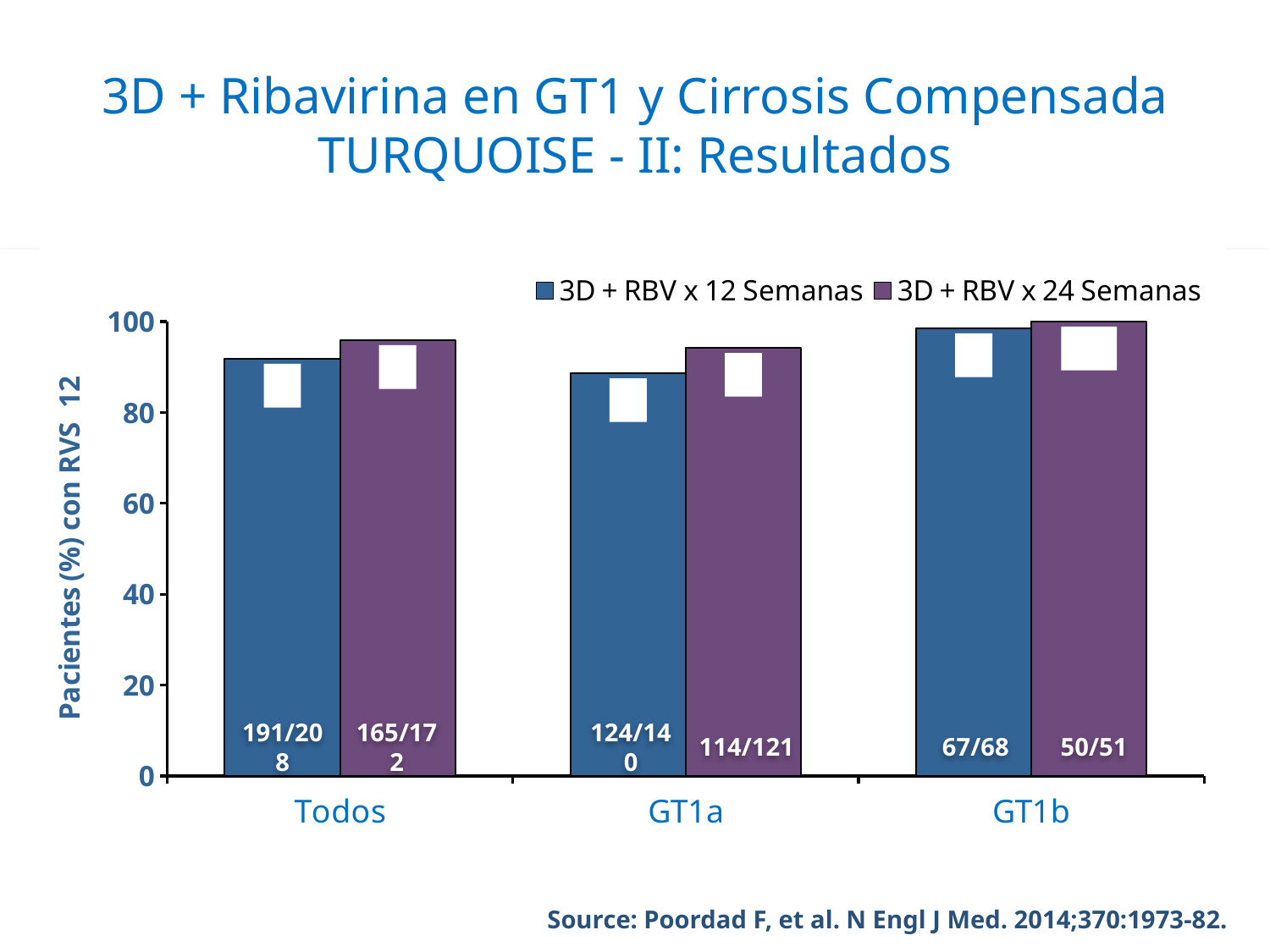
How many categories are shown on the x axis? 3 For Todos, which series has the higher value: 3D + RBV x 12 Semanas or 3D + RBV x 24 Semanas? 3D + RBV x 24 Semanas What is the title of the y axis? Pacientes (%) con RVS 12 How many series does the legend list? 2 Is the value for 3D + RBV x 24 Semanas in Todos greater or less than 80? greater What label is printed on the 3D + RBV x 24 Semanas bar for GT1b? 50/51 Is the value for 3D + RBV x 12 Semanas in GT1a greater or less than 80? greater What label is printed on the 3D + RBV x 12 Semanas bar for Todos? 191/208 What label is printed on the 3D + RBV x 24 Semanas bar for Todos? 165/172 What kind of chart is shown on the slide? bar chart What label is printed on the 3D + RBV x 12 Semanas bar for GT1a? 124/140 For GT1a, which series has the higher value: 3D + RBV x 12 Semanas or 3D + RBV x 24 Semanas? 3D + RBV x 24 Semanas